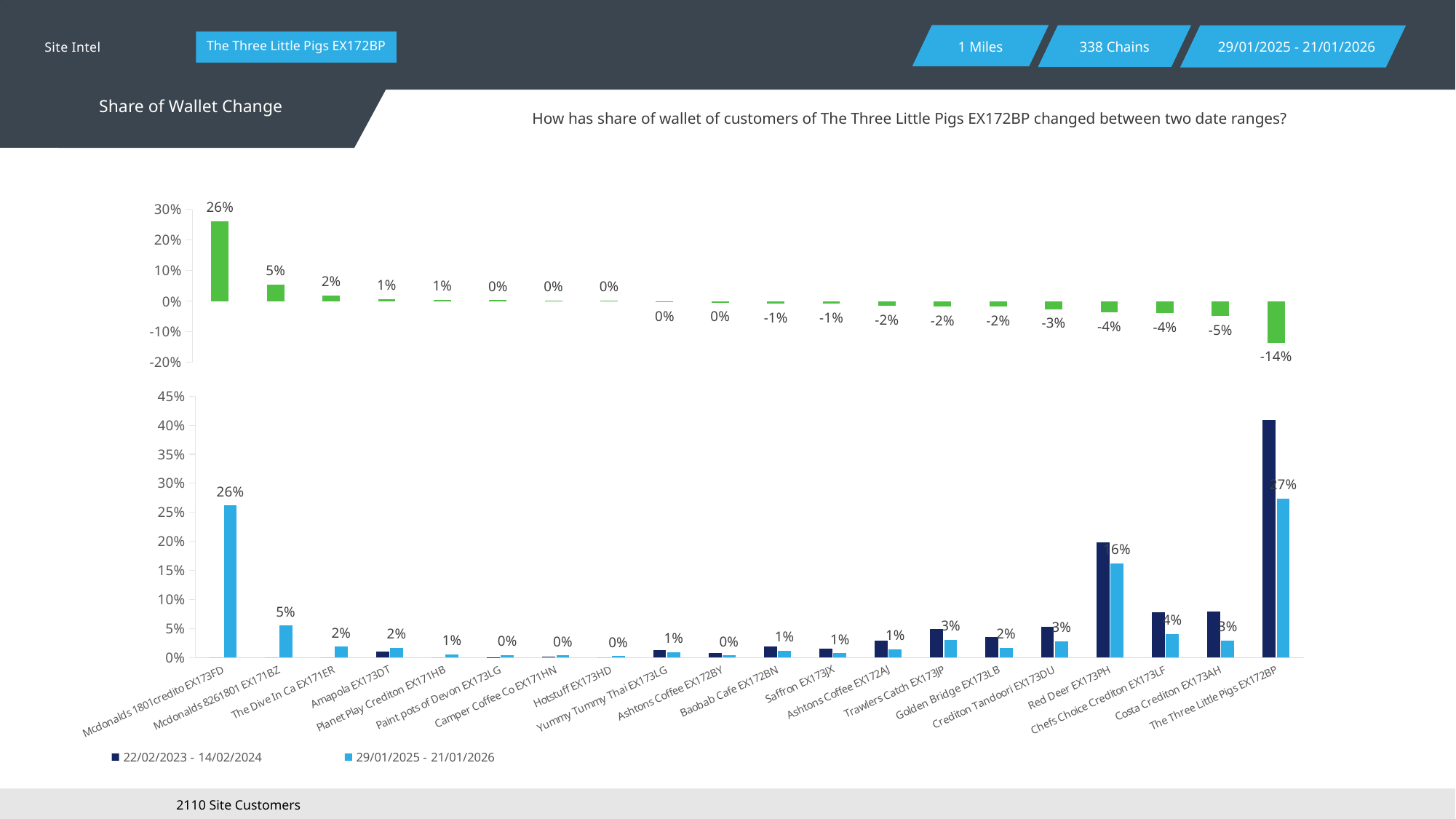
In the bottom chart, is the value for The Three Little Pigs EX172BP in the 22/02/2023 - 14/02/2024 series greater or less than 35%? greater In the top chart, what is the difference between the values for Mcdonalds 8261801 EX171BZ and The Dive In Ca EX171ER? 3 percentage points In the bottom chart, what is the value for The Three Little Pigs EX172BP in the 29/01/2025 - 21/01/2026 series? 27% In the top chart, what is the value for Costa Crediton EX173AH? -5% In the bottom chart, what is the first entry in the legend? 22/02/2023 - 14/02/2024 What kind of chart is the top chart on the slide? Bar chart How many categories are shown on the x axis of the bottom chart? 20 In the top chart, what is the share of wallet change for Mcdonalds 1801credito EX173FD? 26% In the bottom chart, what is the value for Red Deer EX173PH in the 29/01/2025 - 21/01/2026 series? 16% In the top chart, which category has the lowest share of wallet change? The Three Little Pigs EX172BP In the bottom chart, how many series does the legend list? 2 In the bottom chart, which has the larger value in the 29/01/2025 - 21/01/2026 series: Red Deer EX173PH or Chefs Choice Crediton EX173LF? Red Deer EX173PH